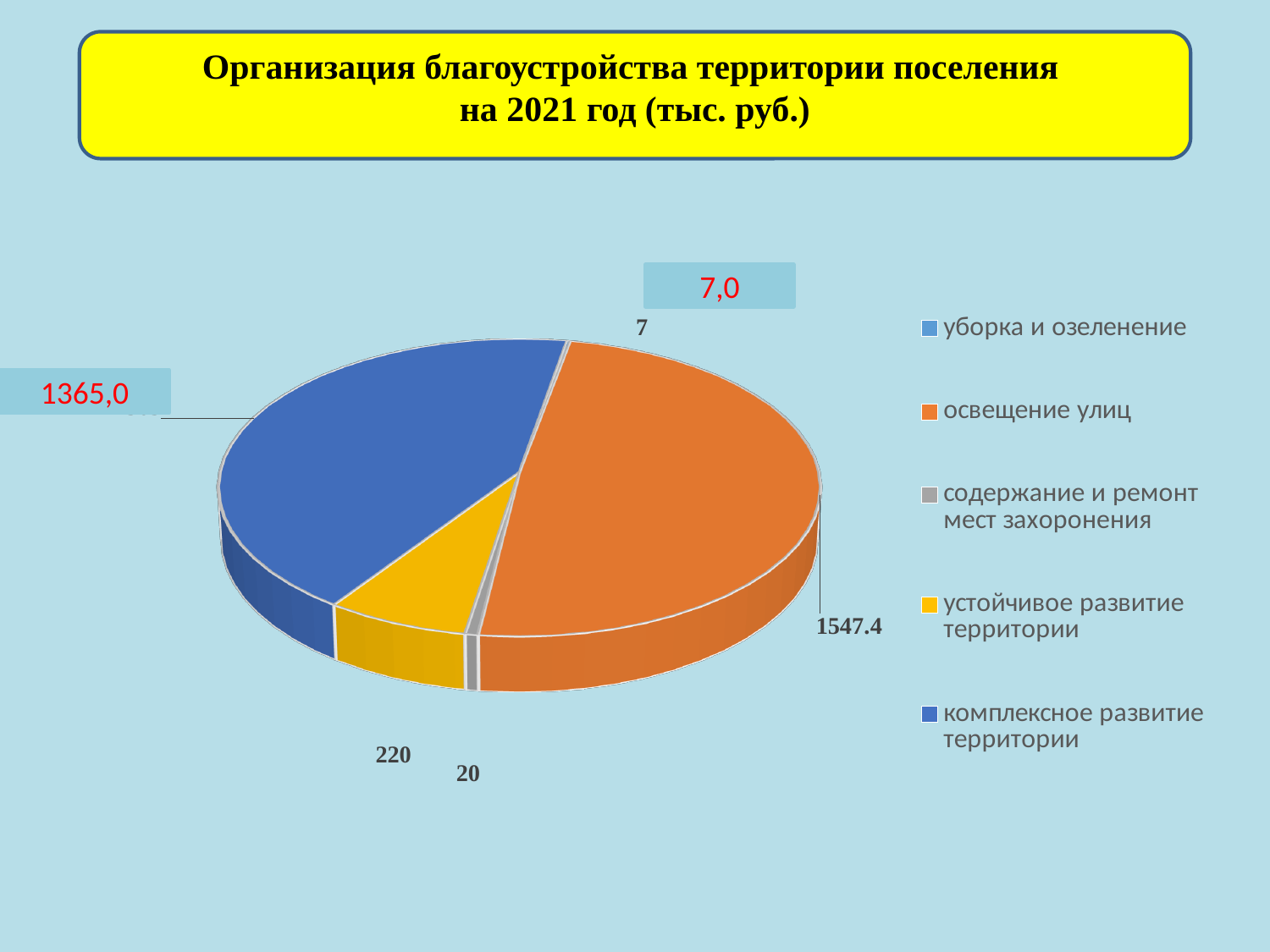
What colour is the slice for освещение улиц? orange What is the value for комплексное развитие территории? 1365,0 What is the value for освещение улиц? 1547.4 Which category has the largest slice of the pie? освещение улиц Which category has the smallest value? уборка и озеленение What is the value for содержание и ремонт мест захоронения? 20 How many categories does the legend of the pie chart list? 5 What kind of chart is shown on the slide? pie chart What is the value for устойчивое развитие территории? 220 Which is larger: the value for устойчивое развитие территории or the value for содержание и ремонт мест захоронения? устойчивое развитие территории What is the value for уборка и озеленение? 7 What is the difference between the values for устойчивое развитие территории and содержание и ремонт мест захоронения? 200